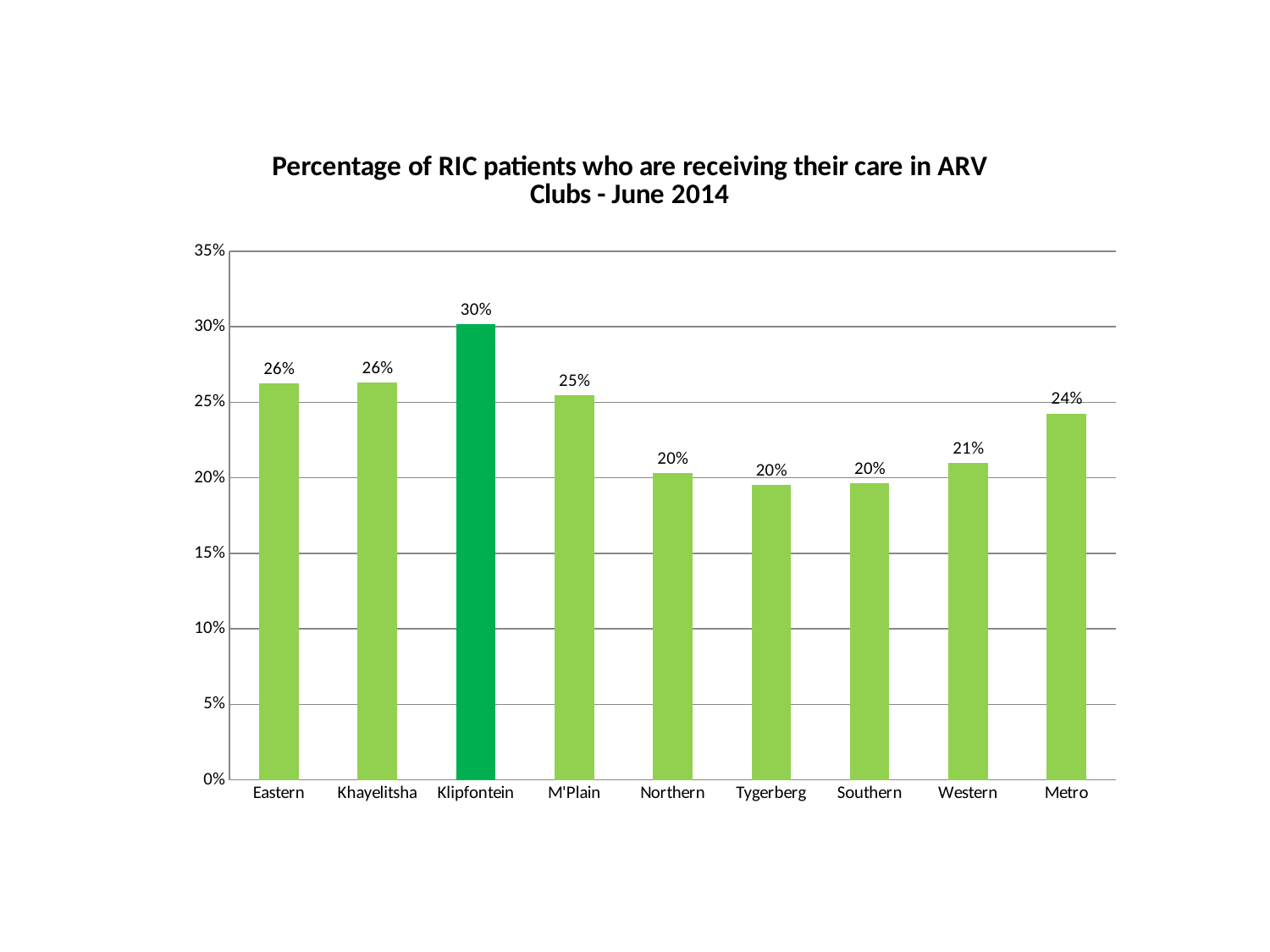
What kind of chart is shown on the slide? bar chart Is the value for Metro greater or less than 25%? less What is the value for Klipfontein? 30% How many categories are shown on the x axis? 9 What is the difference between the values for Eastern and Metro? 2% What is the value for M'Plain? 25% What is the difference between the values for Klipfontein and Northern? 10% Which category has the highest value? Klipfontein Which is larger, the value for Klipfontein or the value for Metro? Klipfontein What is the value for Western? 21% Which bar is shown in a darker green than the others? Klipfontein What is the value for Metro? 24%